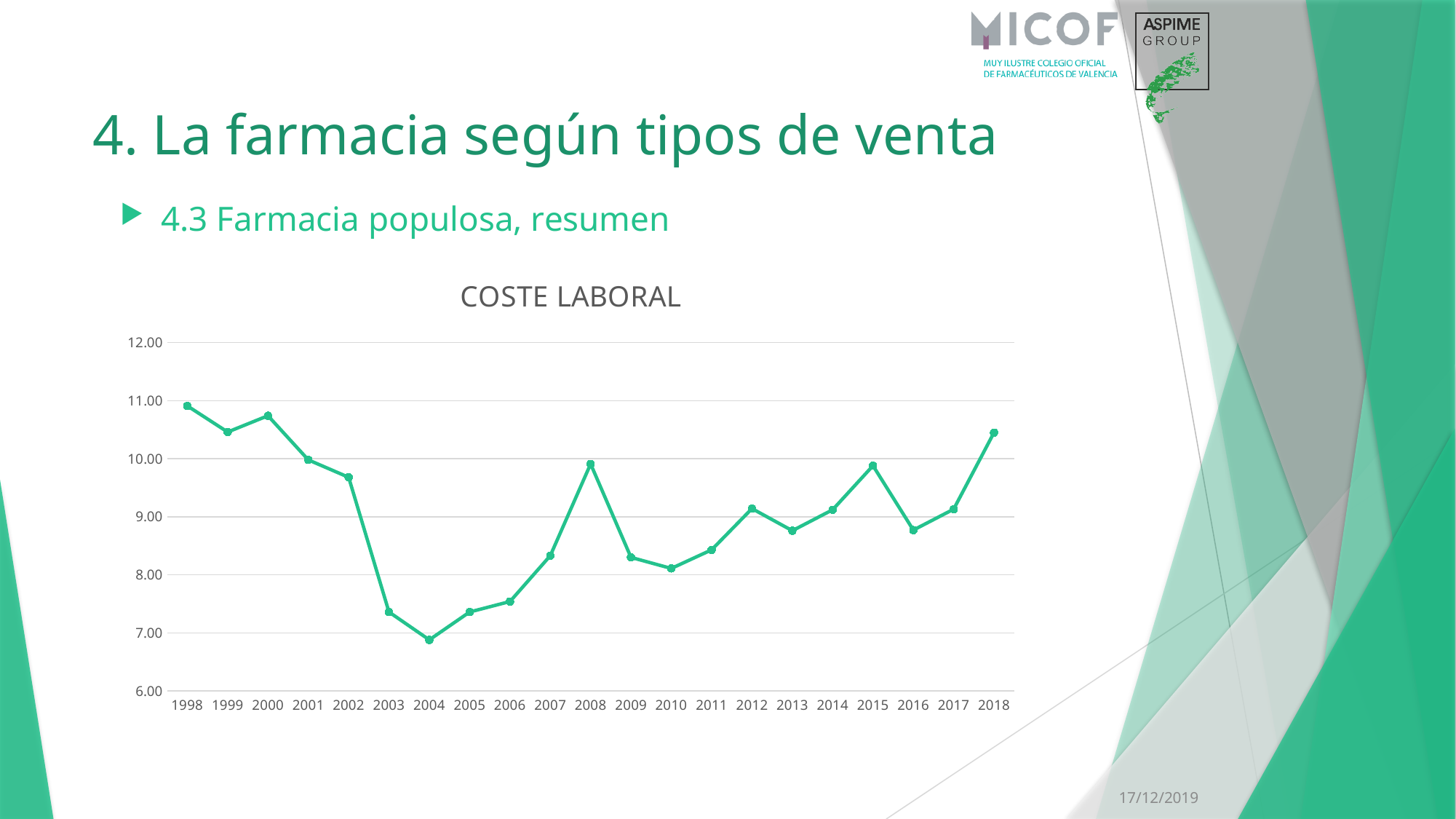
Which is larger, the value for 2004 or the value for 2008? 2008 How many years are plotted on the x axis of the COSTE LABORAL chart? 21 What kind of chart is shown under the title COSTE LABORAL? line chart Which year has the lowest value in the COSTE LABORAL chart? 2004 Which is larger, the value for 1998 or the value for 2010? 1998 Is the value for 2018 greater or less than 10.00? greater What is the title of the chart on the slide? COSTE LABORAL Is the value for 2016 greater or less than 9.00? less Do the values rise or fall from 1998 to 2004 in the COSTE LABORAL chart? fall Which year has the highest value in the COSTE LABORAL chart? 1998 Is the value for 2002 greater or less than 10.00? less